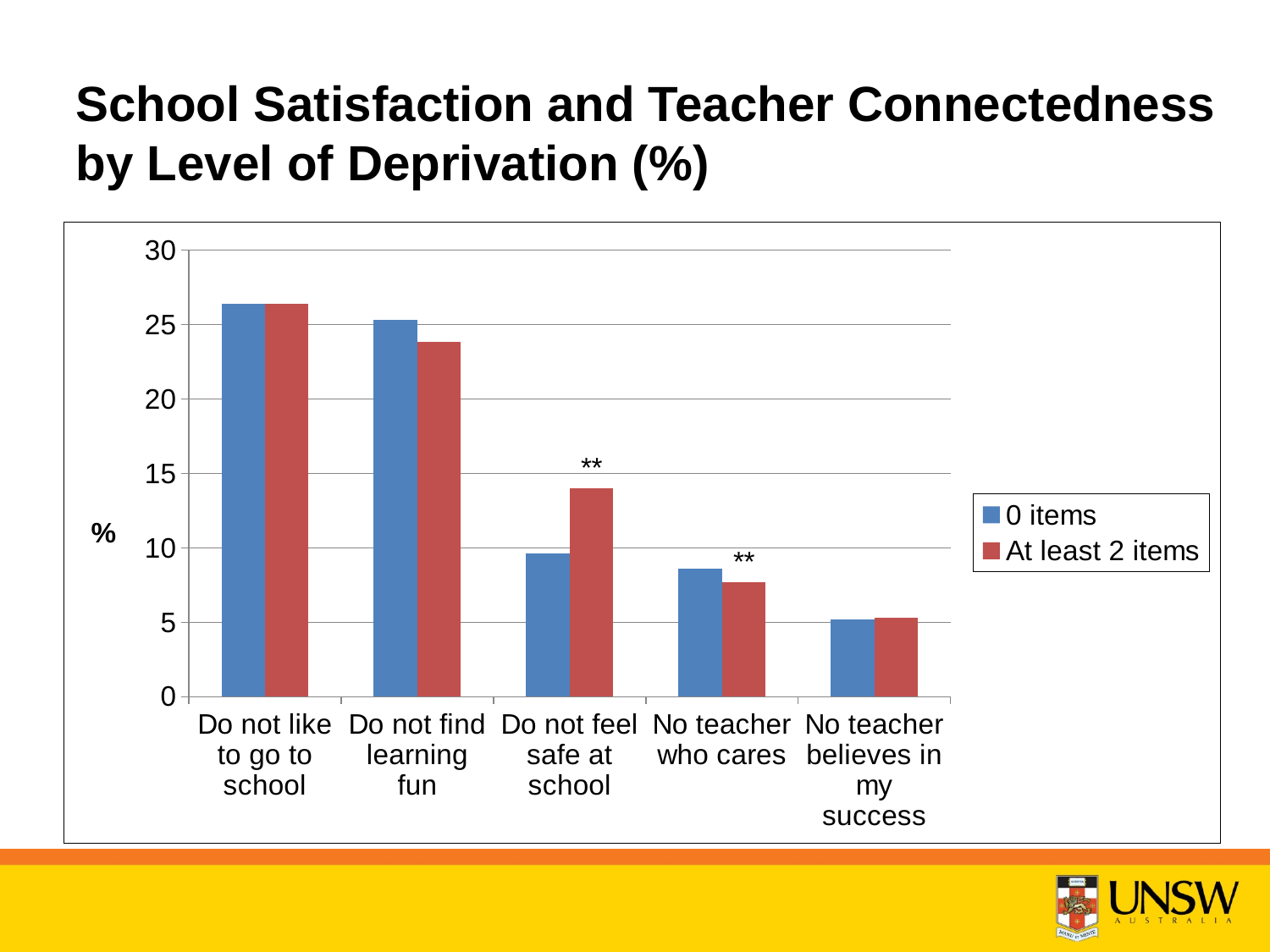
Is the 'At least 2 items' value for 'Do not feel safe at school' greater or less than 10? greater Do the '0 items' values generally rise or fall moving from left to right across the categories? fall How many series does the legend list? 2 For 'Do not feel safe at school', which series has the larger value, '0 items' or 'At least 2 items'? At least 2 items Is the 'At least 2 items' value for 'Do not find learning fun' greater or less than 25? less Is the '0 items' value for 'No teacher who cares' greater or less than 10? less For 'Do not find learning fun', which series has the larger value, '0 items' or 'At least 2 items'? 0 items What kind of chart is shown on the slide? bar chart How many categories are shown along the x axis? 5 Which category has the lowest value for the '0 items' series? No teacher believes in my success Which category has the highest value for the 'At least 2 items' series? Do not like to go to school What label is shown on the vertical axis of the chart? %